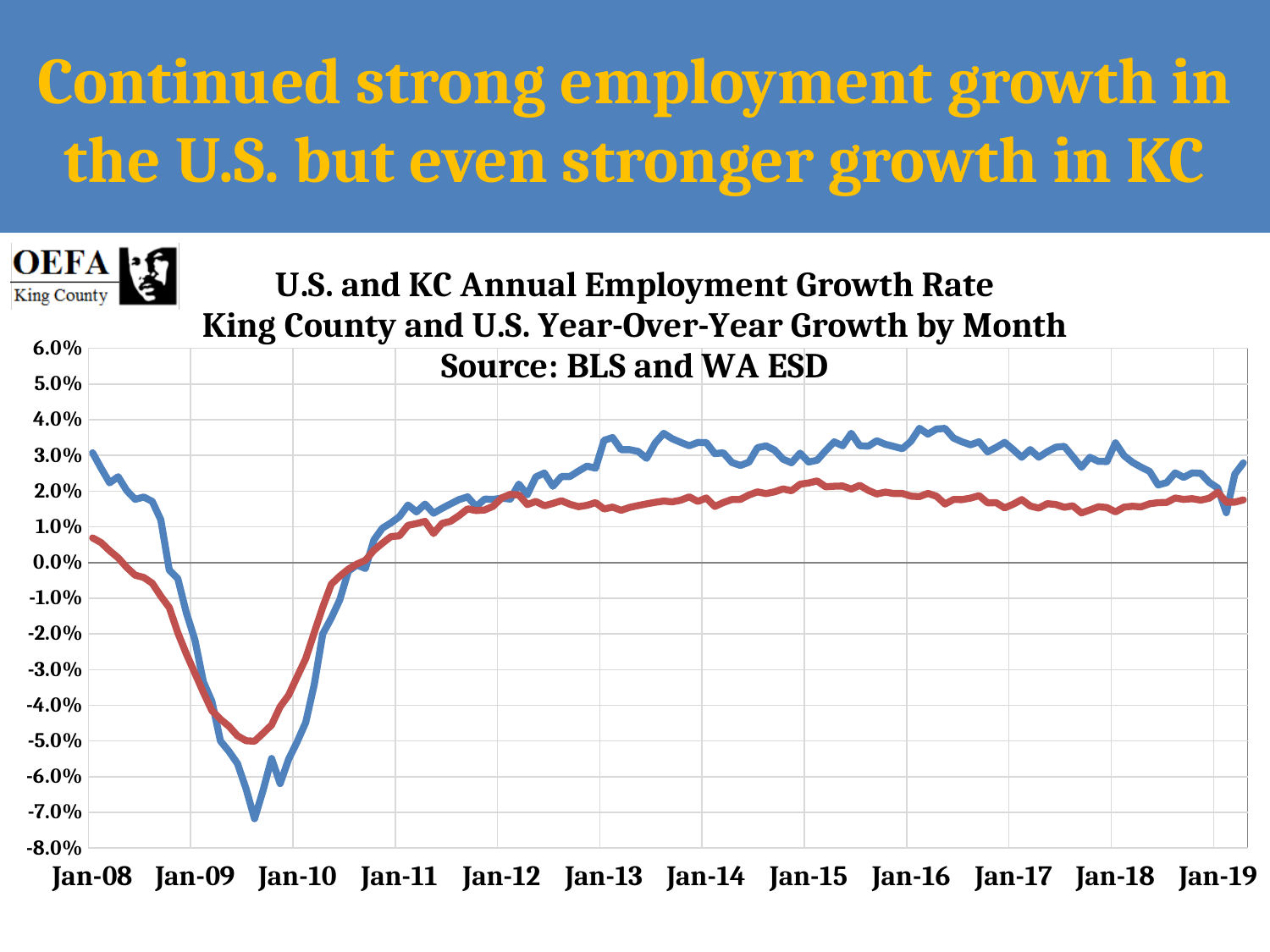
How many lines are plotted on the chart? 2 Is the lowest value of the red line greater or less than -4.0%? less Is the value of the red line at Jan-13 greater or less than 2.0%? less Which line reaches the highest value on the chart, the blue line or the red line? the blue line What source is cited in the chart title? BLS and WA ESD Is the lowest value of the blue line greater or less than -6.0%? less Does the blue line rise or fall between Jan-08 and Jan-09? fall How many year labels are shown on the x axis? 12 What kind of chart is shown on the slide? line chart At Jan-10, which line has the higher value, the blue line or the red line? the red line Which line reaches the lowest value on the chart, the blue line or the red line? the blue line